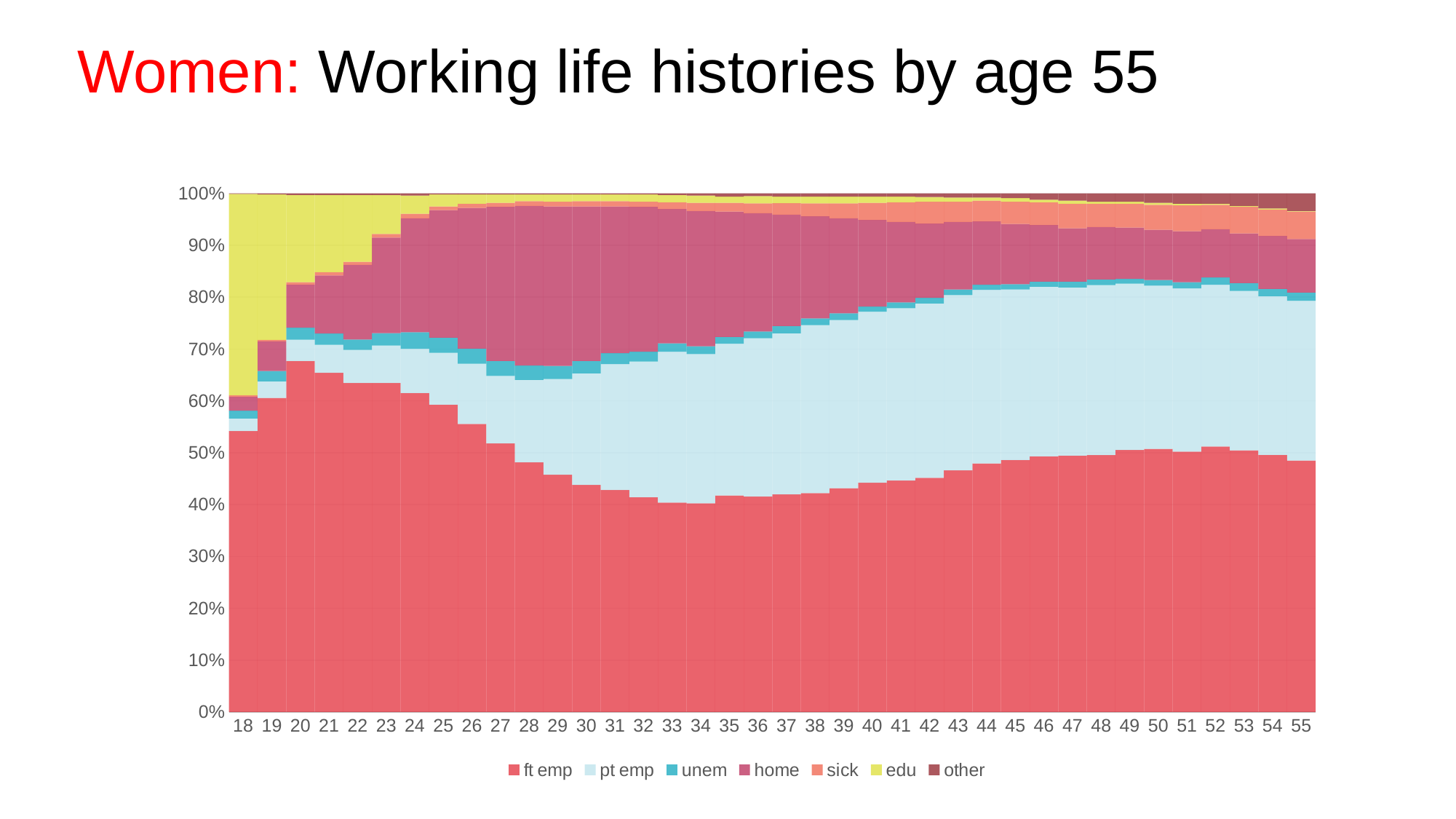
Which is larger, the ft emp share at age 20 or at age 34? age 20 How many age categories are shown along the x axis? 38 Is the value for ft emp at age 20 greater or less than 60%? greater Which series is shown in yellow? edu Is the value for ft emp at age 40 greater or less than 50%? less Is the value for ft emp at age 28 greater or less than 50%? less What kind of chart is shown on the slide? stacked bar chart At which age is the ft emp share highest? 20 Does the ft emp share rise or fall from age 20 to age 34? fall What is the title of the slide? Women: Working life histories by age 55 How many series does the legend list? 7